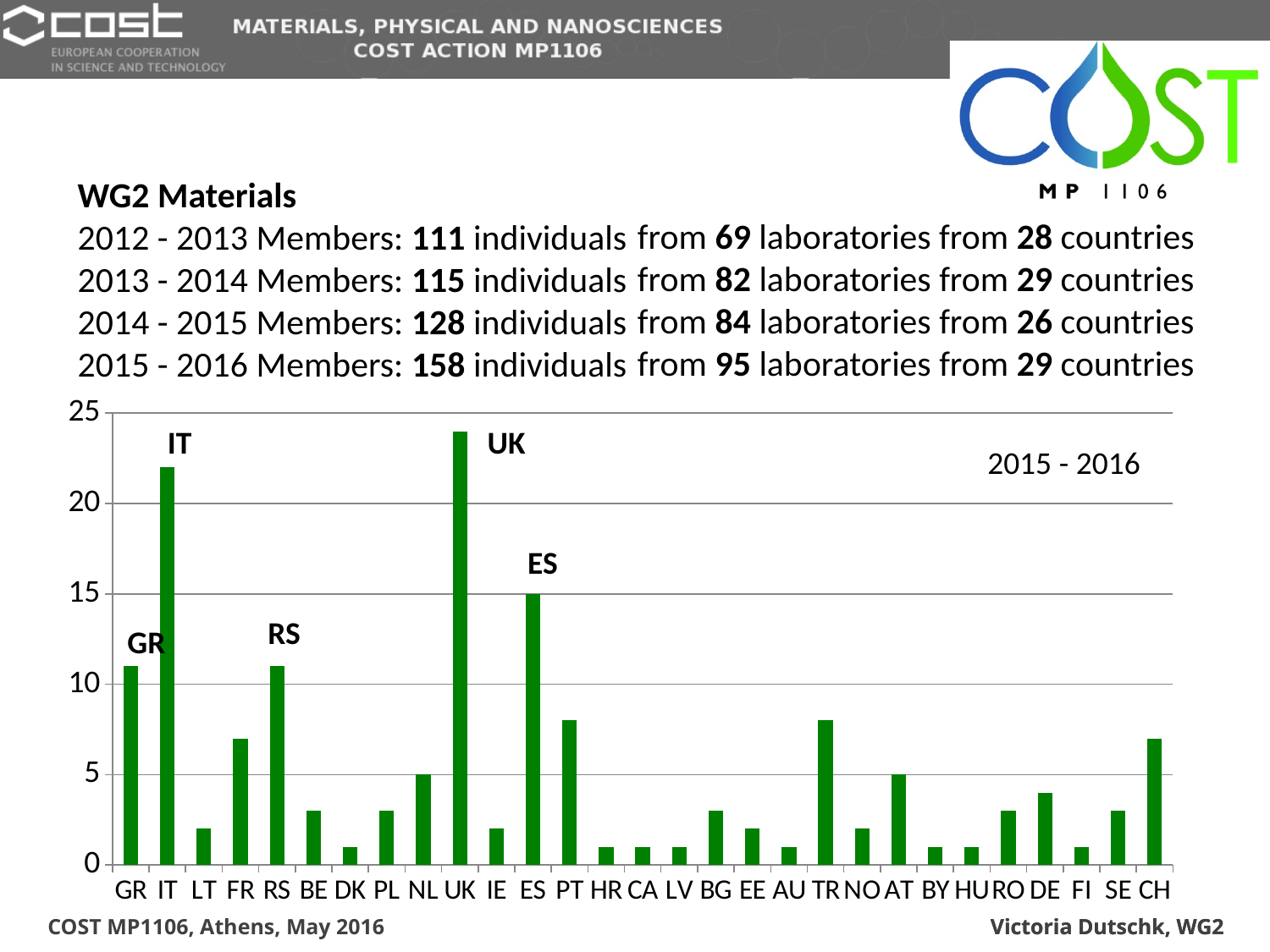
Which country has the highest bar in the chart? UK Is the value for UK greater or less than 20? greater Is the value for IT greater or less than 20? greater What kind of chart is shown on the slide? bar chart Which has the larger value, UK or RS? UK Is the value for GR greater or less than 10? greater How many countries are shown along the x axis of the chart? 29 Which has the larger value, IT or ES? IT What colour are the bars in the chart? green What period does the chart cover, according to the label in the plot area? 2015 - 2016